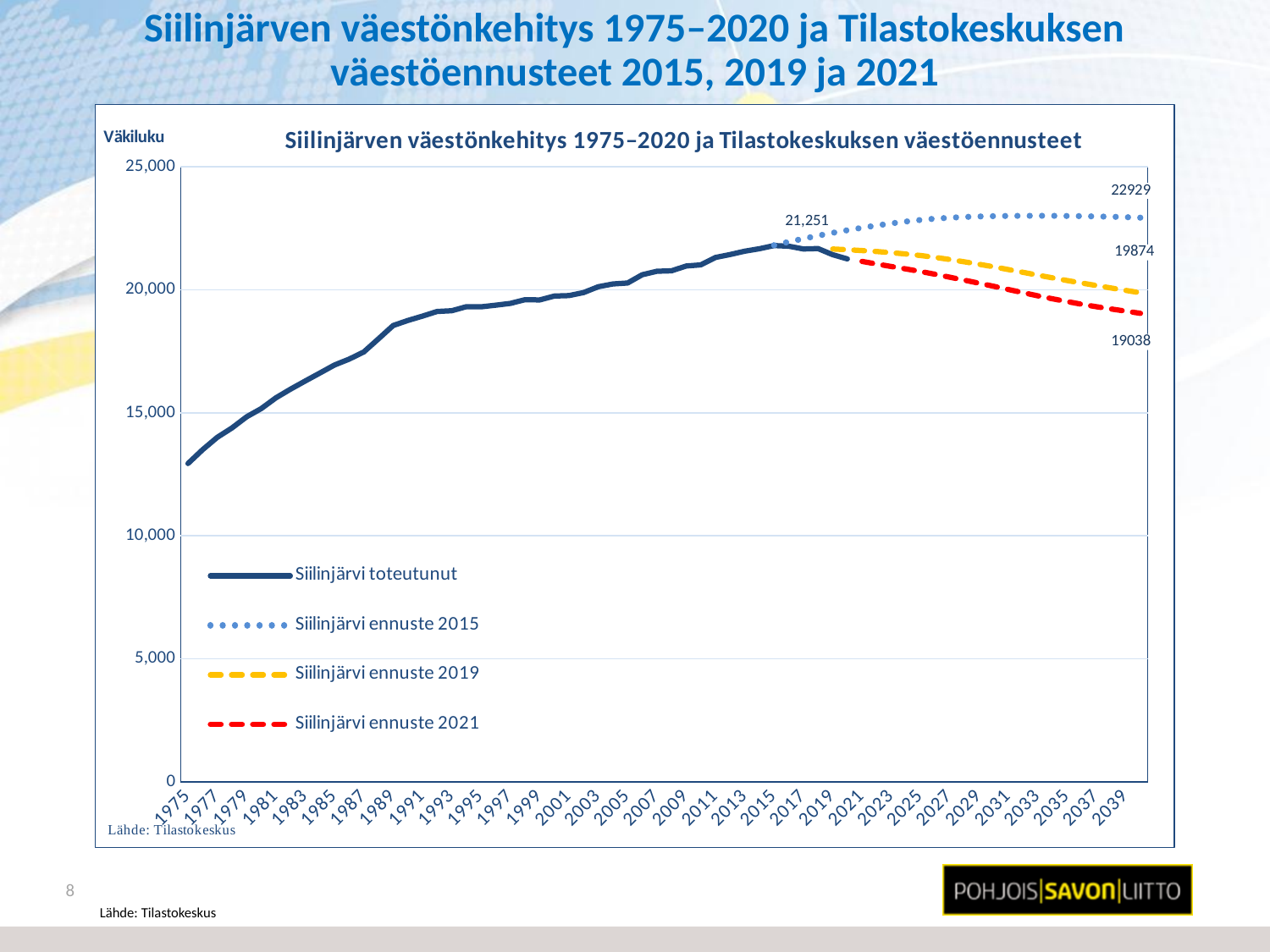
How many series does the legend list? 4 What is the labelled end value of the Siilinjärvi ennuste 2021 line? 19038 Is the value of the Siilinjärvi toteutunut line in 1975 greater or less than 15,000? less Which forecast series ends at the lowest value? Siilinjärvi ennuste 2021 What is the difference between the labelled end values of the ennuste 2019 and ennuste 2021 lines? 836 What kind of chart is shown on the slide? line chart Does the Siilinjärvi toteutunut line rise or fall from 1975 to 2015? rise What is the labelled end value of the Siilinjärvi ennuste 2019 line? 19874 What is the label on the vertical axis of the chart? Väkiluku What is the difference between the labelled end values of the ennuste 2015 and ennuste 2021 lines? 3891 What is the labelled end value of the Siilinjärvi ennuste 2015 line? 22929